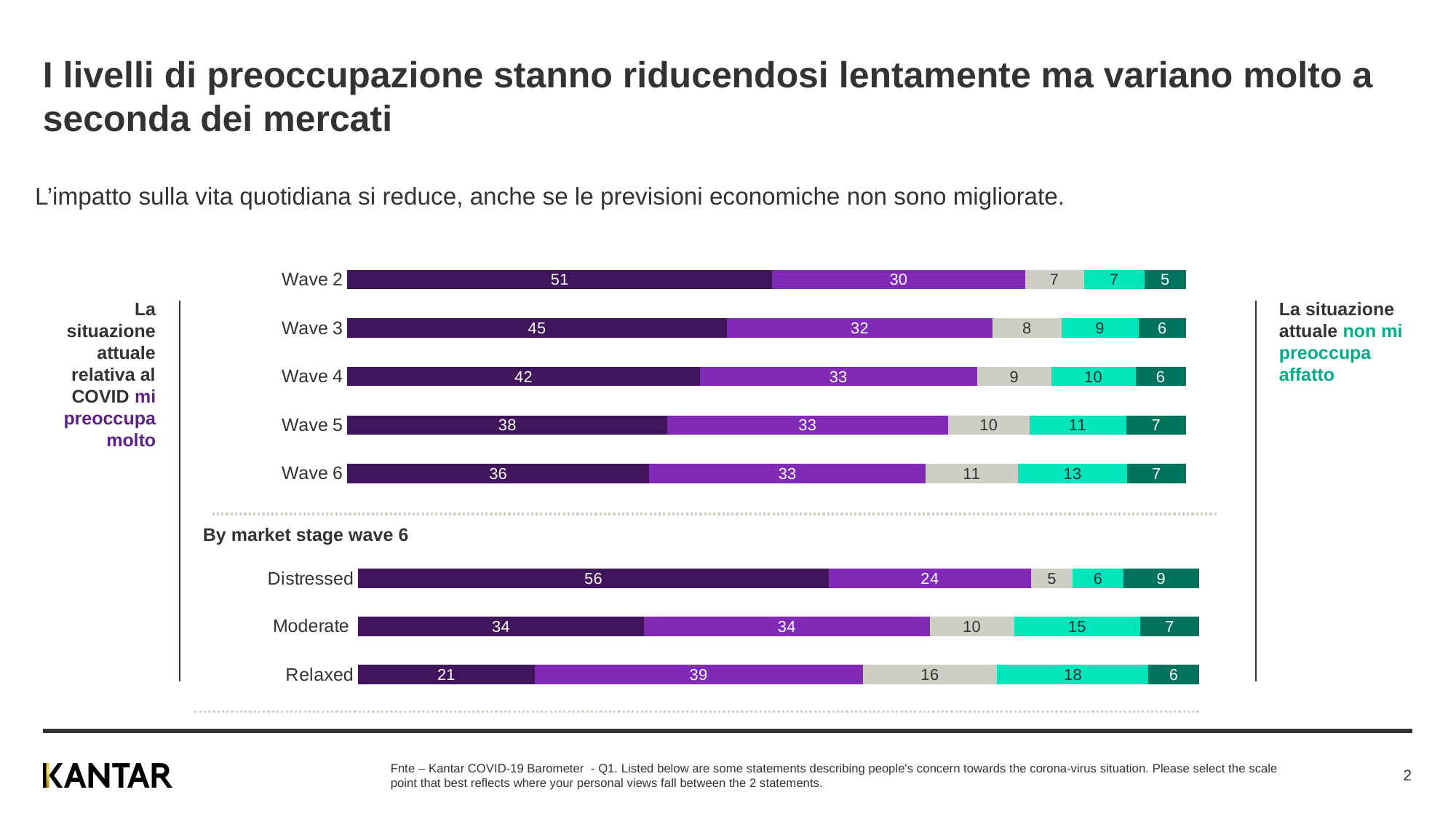
How many market stage categories are shown in the bottom chart? 3 In the top chart, what is the difference between the dark purple (leftmost) segment for Wave 2 and for Wave 6? 15 In the bottom chart (By market stage wave 6), what is the difference between the dark purple (leftmost) segment for Distressed and for Relaxed? 35 In the top chart (Wave 2 to Wave 6), which wave has the largest dark purple (leftmost) segment? Wave 2 In the top chart (Wave 2 to Wave 6), what is the value of the dark purple (leftmost) segment for Wave 2? 51 In the bottom chart (By market stage wave 6), which has the larger bright cyan (fourth) segment, Moderate or Distressed? Moderate In the bottom chart (By market stage wave 6), what is the value of the dark purple (leftmost) segment for Distressed? 56 What kind of chart is used on this slide? Stacked bar chart In the top chart (Wave 2 to Wave 6), which wave has the smallest dark purple (leftmost) segment? Wave 6 In the top chart, what is the total of the Wave 5 stacked bar? 99 How many waves are shown in the top chart? 5 In the top chart, does the dark purple (leftmost) segment rise or fall from Wave 2 to Wave 6? Fall